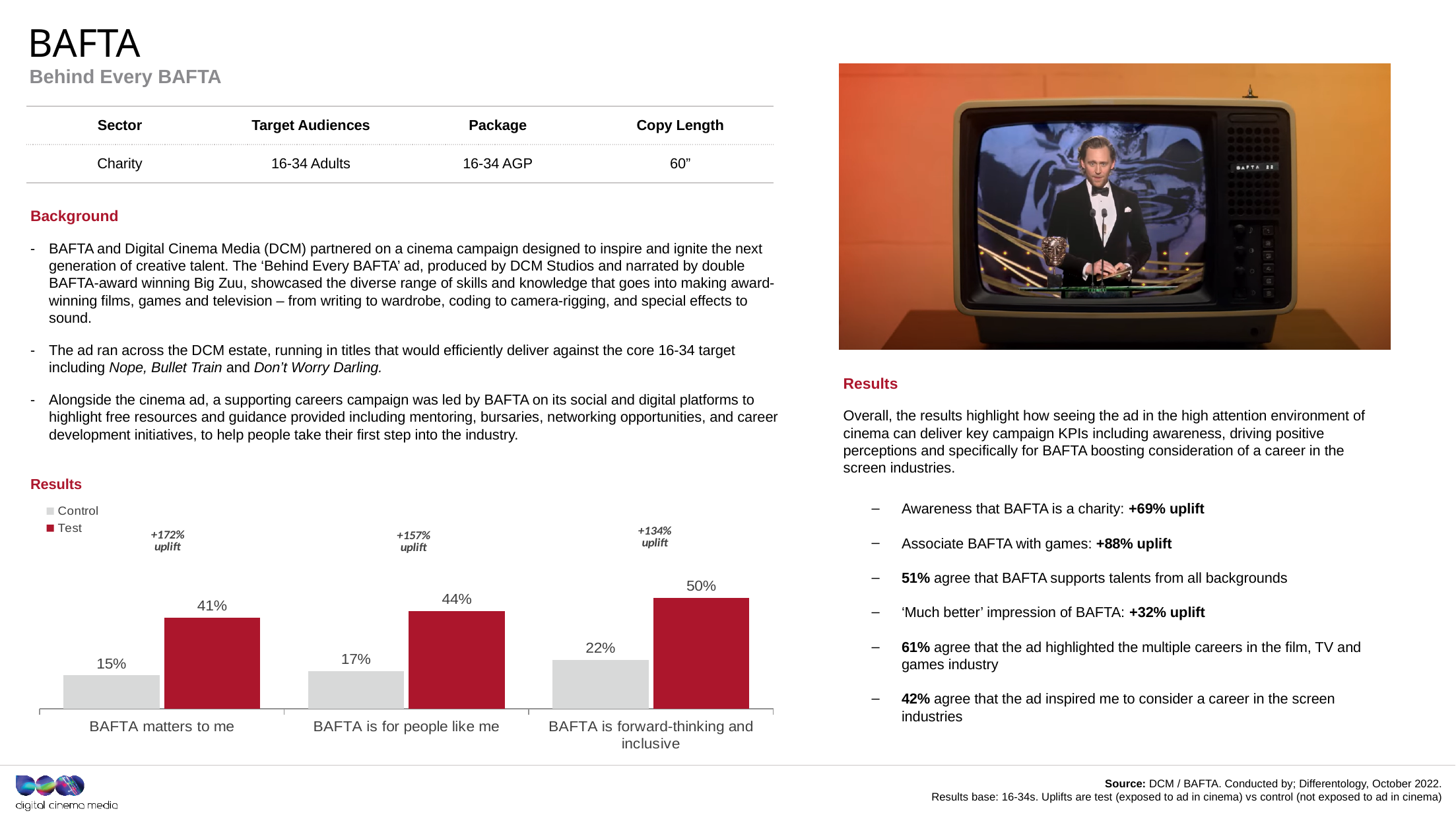
Which category has the lowest Control value? BAFTA matters to me What is the Control value for 'BAFTA is for people like me'? 17% Which category has the highest Test value? BAFTA is forward-thinking and inclusive How many series does the chart legend list? 2 What uplift is shown above the bars for 'BAFTA is for people like me'? +157% uplift Which is larger: the Control value for 'BAFTA is forward-thinking and inclusive' or the Control value for 'BAFTA is for people like me'? BAFTA is forward-thinking and inclusive What is the Test value for 'BAFTA is forward-thinking and inclusive'? 50% What is the Test value for 'BAFTA matters to me'? 41% How many categories are shown on the x axis of the chart? 3 What is the difference between the Test and Control values for 'BAFTA is for people like me'? 27% What kind of chart is shown in the Results section? Bar chart What is the Control value for 'BAFTA matters to me'? 15%